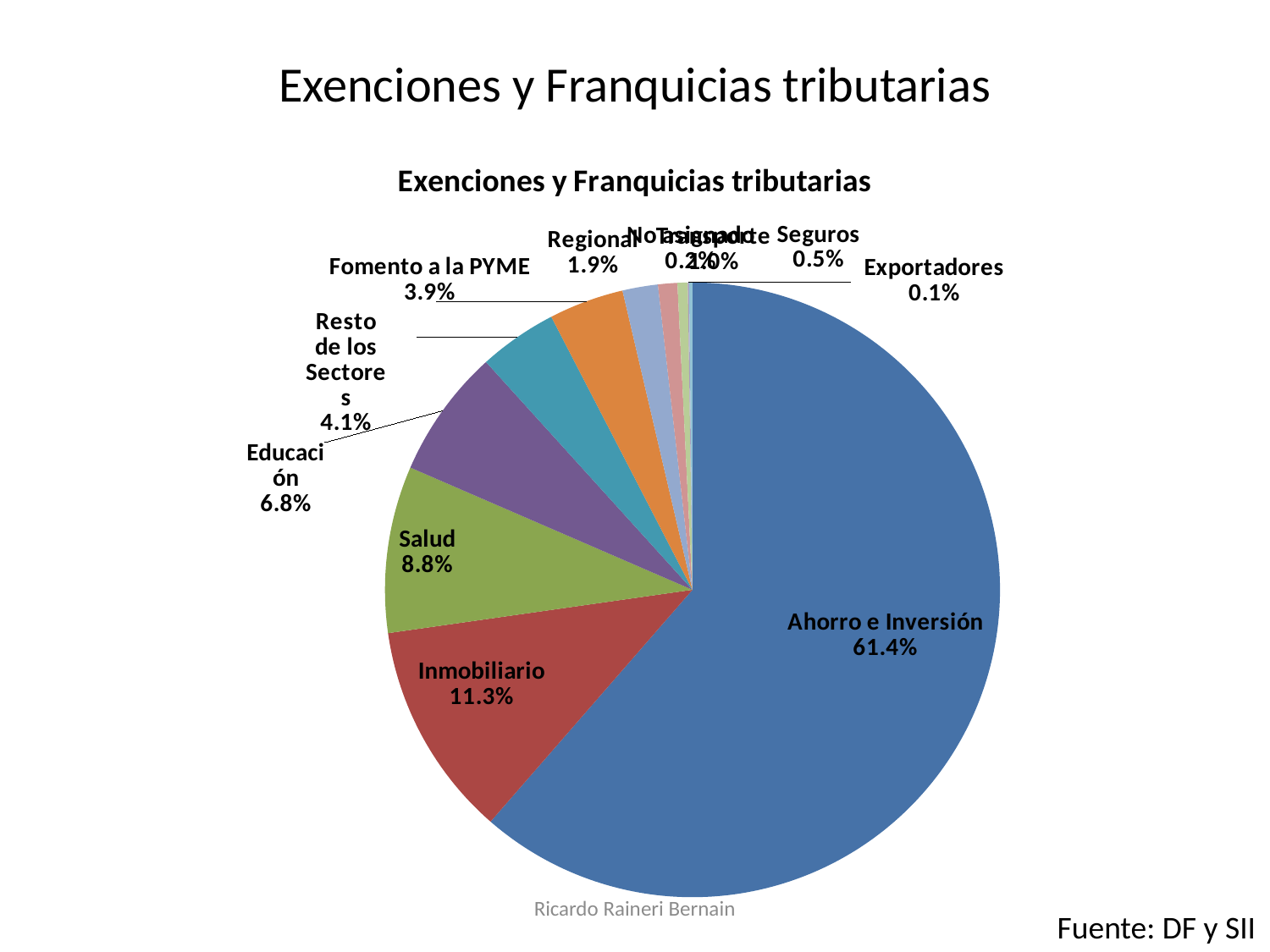
Which is larger, the share for Resto de los Sectores or the share for Regional? Resto de los Sectores What is the value shown for Educación? 6.8% What is the value shown for Salud? 8.8% What is the value shown for Seguros? 0.5% Which category has the smallest slice of the pie? Exportadores What share of the pie does Ahorro e Inversión represent? 61.4% What type of chart is shown on the slide? pie chart What is the difference between the shares of Inmobiliario and Salud? 2.5% What is the title of the chart? Exenciones y Franquicias tributarias What is the value shown for Fomento a la PYME? 3.9% What is the value shown for Inmobiliario? 11.3% Which category has the largest slice of the pie? Ahorro e Inversión